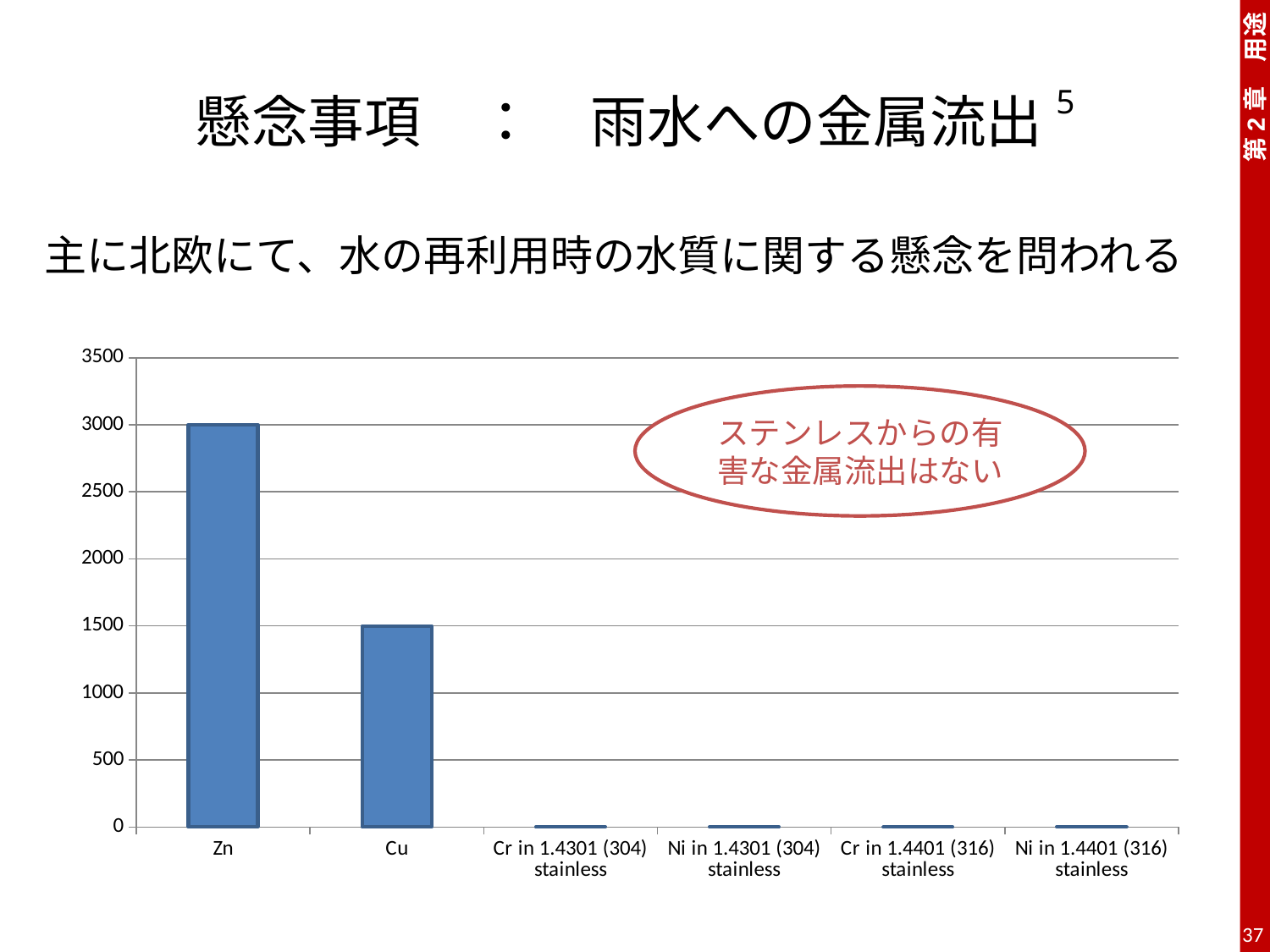
How many categories are shown on the x axis of the chart? 6 Is the value for Cr in 1.4301 (304) stainless greater or less than 500? less Which category has the highest bar in the chart? Zn What is the value for Cu in the chart? 1500 Is the value for Cu greater or less than 1000? greater Which is larger, the value for Cu or the value for Ni in 1.4301 (304) stainless? Cu Is the value for Ni in 1.4401 (316) stainless greater or less than 500? less What is the value for Zn in the chart? 3000 Which is larger, the value for Zn or the value for Cu? Zn What kind of chart is shown on the slide? bar chart What is the difference between the values for Zn and Cu? 1500 What colour are the bars in the chart? blue